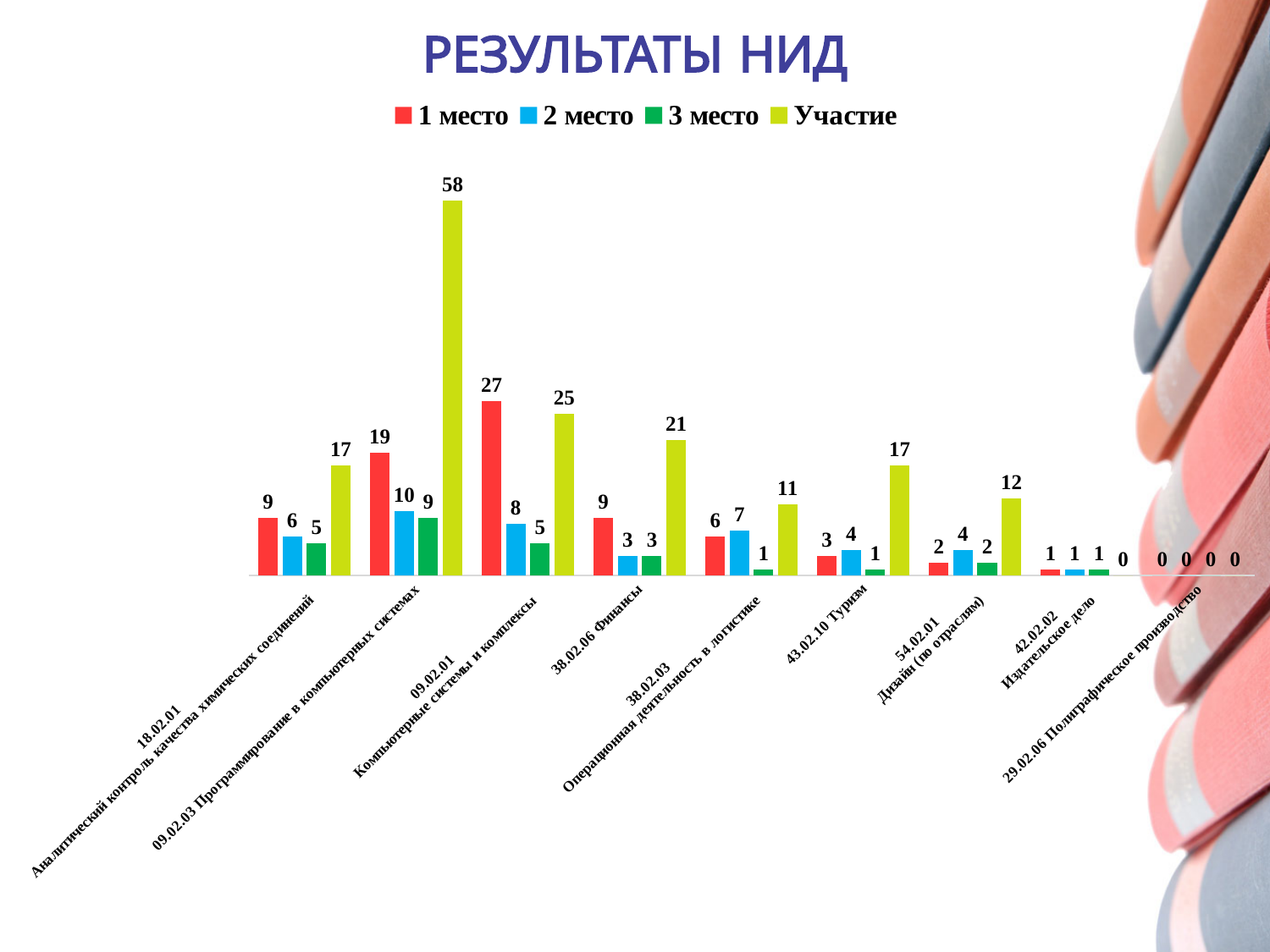
What kind of chart is shown on the slide? Bar chart How many categories are shown on the x axis? 9 Which category has the highest value for "Участие"? 09.02.03 Программирование в компьютерных системах How many series does the legend list? 4 Which is larger: the "1 место" value for 38.02.06 Финансы or the "1 место" value for 43.02.10 Туризм? 38.02.06 Финансы What is the value of "1 место" for 09.02.01 Компьютерные системы и комплексы? 27 What is the title of the chart? РЕЗУЛЬТАТЫ НИД What is the total of all four series for 42.02.02 Издательское дело? 3 What is the value of "Участие" for 09.02.03 Программирование в компьютерных системах? 58 Which category has the highest value for "1 место"? 09.02.01 Компьютерные системы и комплексы What is the difference between the "Участие" values for 09.02.03 Программирование в компьютерных системах and 09.02.01 Компьютерные системы и комплексы? 33 What is the value of "2 место" for 38.02.03 Операционная деятельность в логистике? 7